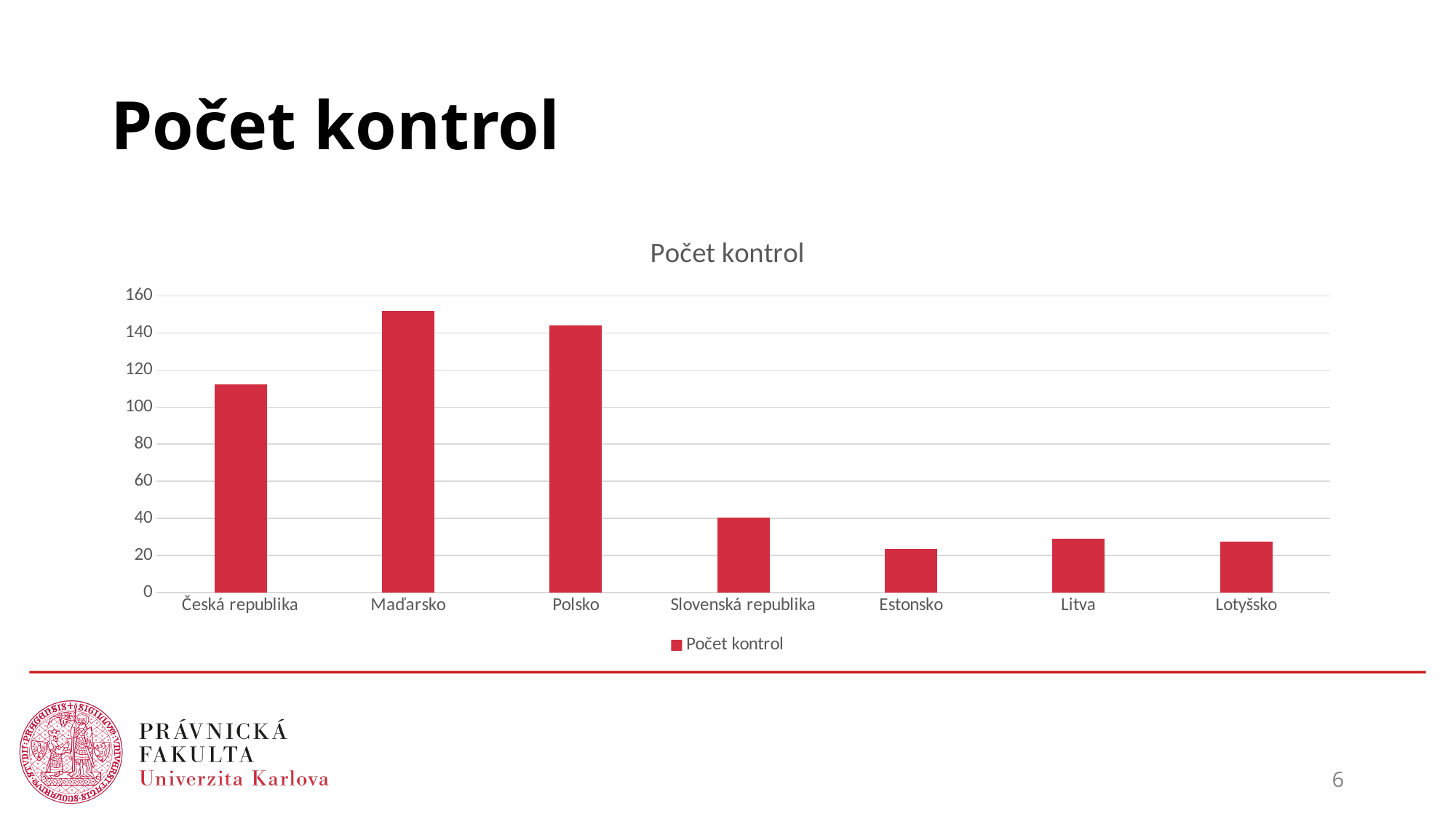
How many countries are shown on the x axis of the chart? 7 What is the title of the chart? Počet kontrol Which country has the highest number of kontrol in the chart? Maďarsko How many series does the chart legend list? 1 Is the value for Lotyšsko greater or less than 40? less Is the value for Polsko greater or less than 120? greater What type of chart is shown on the slide? bar chart Is the value for Česká republika greater or less than 100? greater Which has a larger value, Slovenská republika or Estonsko? Slovenská republika Which has a larger value, Česká republika or Polsko? Polsko